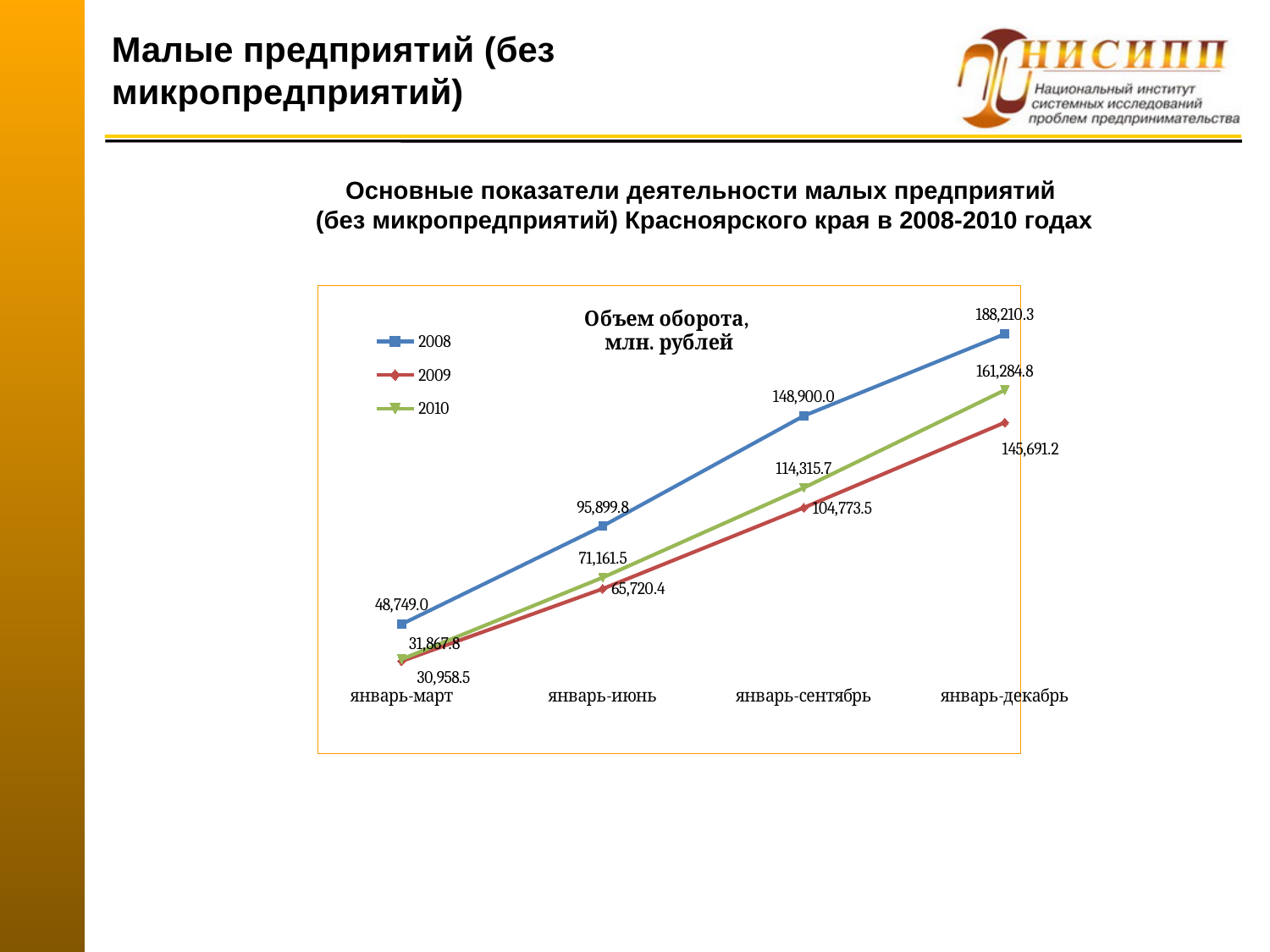
What type of chart is shown on the slide? line chart Do the values for 2008 rise or fall from январь-март to январь-декабрь? rise What is the difference between the 2008 and 2009 values in январь-декабрь? 42,519.1 What is the value for 2010 in январь-июнь? 71,161.5 How many categories are shown on the x axis? 4 Which is larger, the 2010 value in январь-сентябрь or the 2009 value in январь-сентябрь? 2010 What is the value for 2008 in январь-декабрь? 188,210.3 What is the title of the chart? Объем оборота, млн. рублей What is the value for 2009 in январь-сентябрь? 104,773.5 How many series does the legend list? 3 Which series has the highest value in январь-декабрь? 2008 Which series has the lowest value in январь-сентябрь? 2009